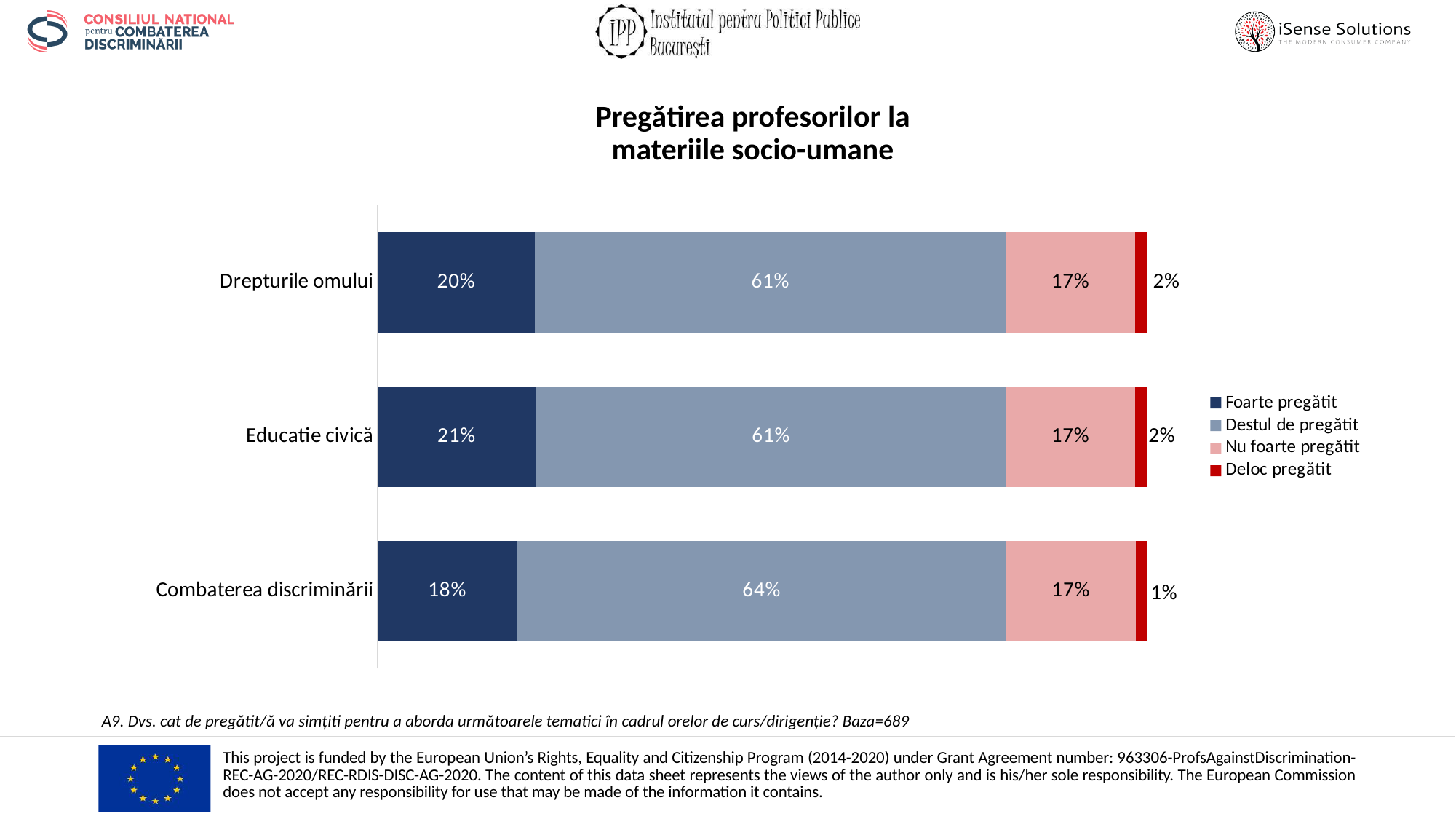
What is the 'Deloc pregătit' value for 'Educatie civică'? 2% What is the difference between the 'Destul de pregătit' values for 'Combaterea discriminării' and 'Drepturile omului'? 3% What is the 'Nu foarte pregătit' value for 'Educatie civică'? 17% What percentage of teachers feel 'Foarte pregătit' for 'Drepturile omului'? 20% What is the title of the chart? Pregătirea profesorilor la materiile socio-umane What is the 'Destul de pregătit' value for 'Combaterea discriminării'? 64% Which category has the lowest 'Foarte pregătit' value? Combaterea discriminării What kind of chart is shown on the slide? Stacked bar chart How many series does the legend list? 4 How many categories are shown on the chart? 3 Which category has the highest 'Foarte pregătit' value? Educatie civică Which is larger: the 'Foarte pregătit' value for 'Educatie civică' or for 'Combaterea discriminării'? Educatie civică